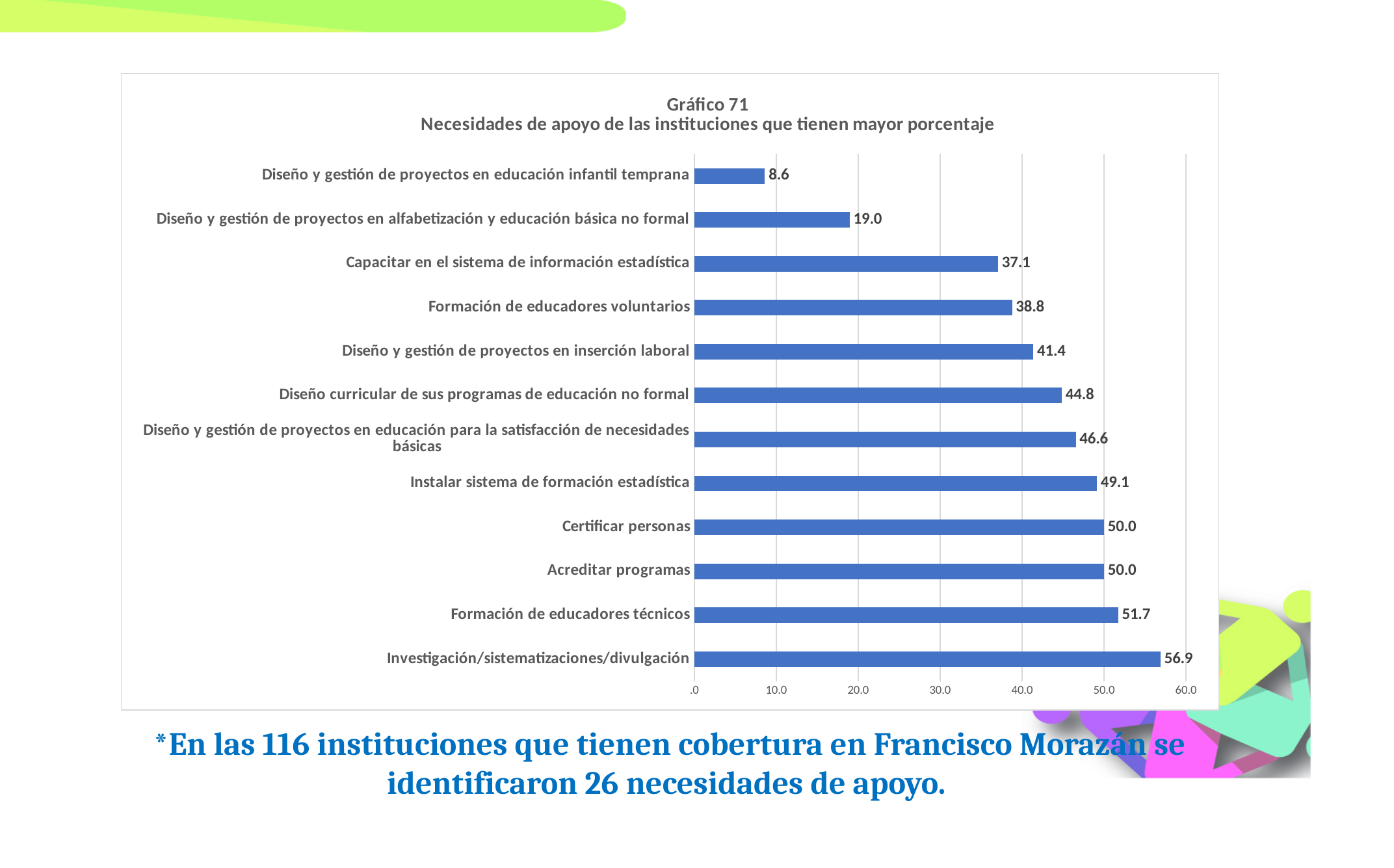
Which category has the highest value? Investigación/sistematizaciones/divulgación What is the difference between the values for Diseño y gestión de proyectos en alfabetización y educación básica no formal and Diseño y gestión de proyectos en educación infantil temprana? 10.4 What is the difference between the values for Formación de educadores técnicos and Certificar personas? 1.7 Which is larger, the value for Capacitar en el sistema de información estadística or the value for Diseño curricular de sus programas de educación no formal? Diseño curricular de sus programas de educación no formal What is the value for Diseño y gestión de proyectos en educación infantil temprana? 8.6 Which category has the lowest value? Diseño y gestión de proyectos en educación infantil temprana What is the value for Investigación/sistematizaciones/divulgación? 56.9 What is the value for Formación de educadores voluntarios? 38.8 What kind of chart is shown on the slide? Bar chart How many categories are shown in the chart? 12 What is the number of the chart given in its title? Gráfico 71 Is the value for Instalar sistema de formación estadística greater or less than 40.0? greater